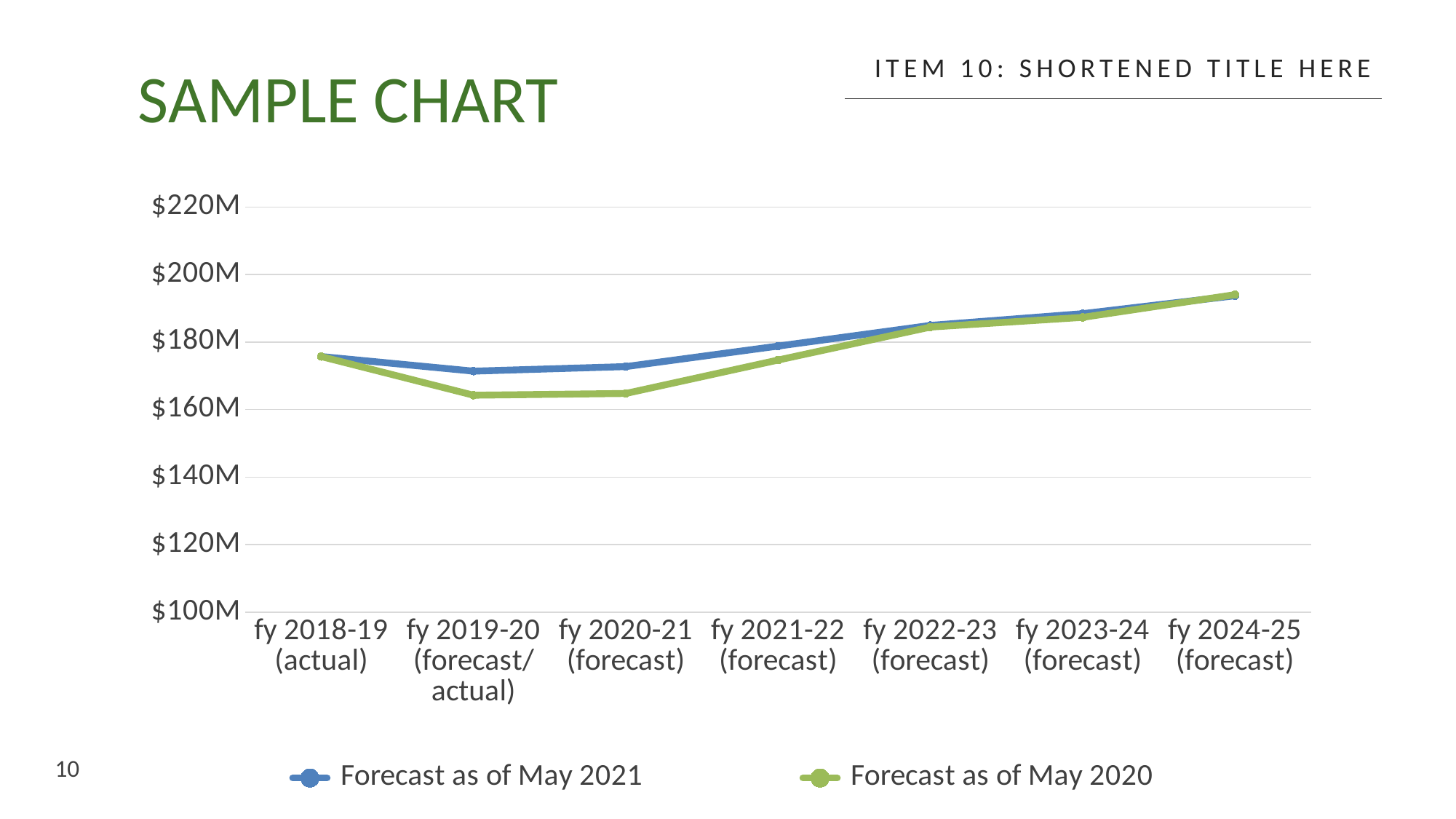
What kind of chart is shown on the slide? line chart Which fiscal year has the highest value for the Forecast as of May 2020 series? fy 2024-25 (forecast) Which fiscal year has the highest value for the Forecast as of May 2021 series? fy 2024-25 (forecast) How many series does the legend list? 2 Is the Forecast as of May 2021 value for fy 2019-20 greater or less than $180M? less Is the Forecast as of May 2021 value for fy 2024-25 greater or less than $200M? less Is the Forecast as of May 2021 value for fy 2022-23 greater or less than $180M? greater How many fiscal years are plotted along the x axis? 7 Do the values of the Forecast as of May 2020 series rise or fall from fy 2020-21 to fy 2024-25? rise For fy 2019-20, which series has the higher value, Forecast as of May 2021 or Forecast as of May 2020? Forecast as of May 2021 What is the title of the chart on the slide? SAMPLE CHART